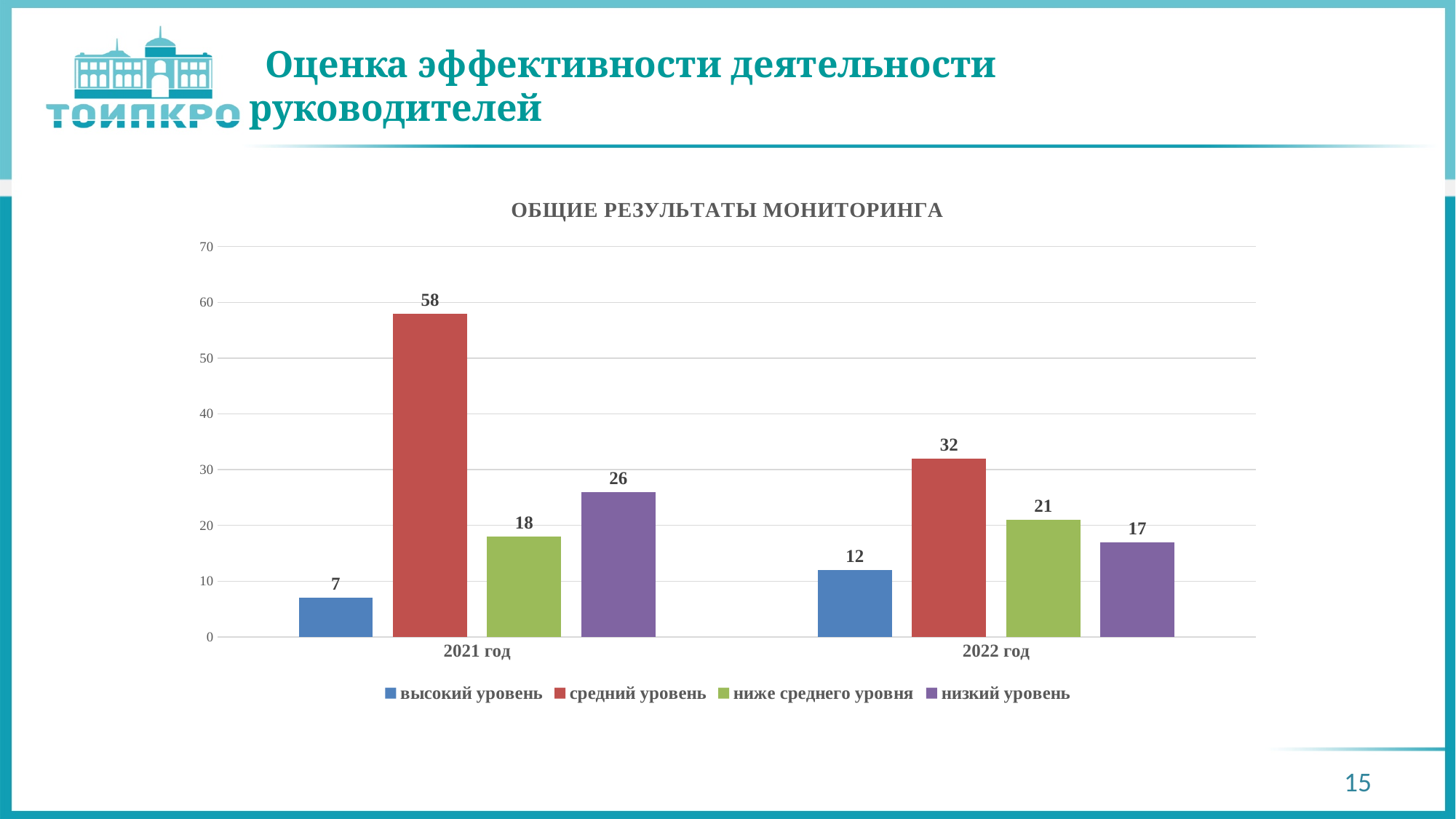
What is the value for "низкий уровень" in 2021 год? 26 Which is larger: "ниже среднего уровня" in 2021 год or in 2022 год? 2022 год Which series has the lowest value in 2022 год? высокий уровень What is the difference between the "средний уровень" values for 2021 год and 2022 год? 26 What is the value for "ниже среднего уровня" in 2022 год? 21 What is the value for "высокий уровень" in 2022 год? 12 How many categories are shown on the x axis? 2 What is the title of the chart? ОБЩИЕ РЕЗУЛЬТАТЫ МОНИТОРИНГА Which series has the highest value in 2021 год? средний уровень How many series does the legend list? 4 What kind of chart is shown on the slide? bar chart What is the value for "средний уровень" in 2021 год? 58